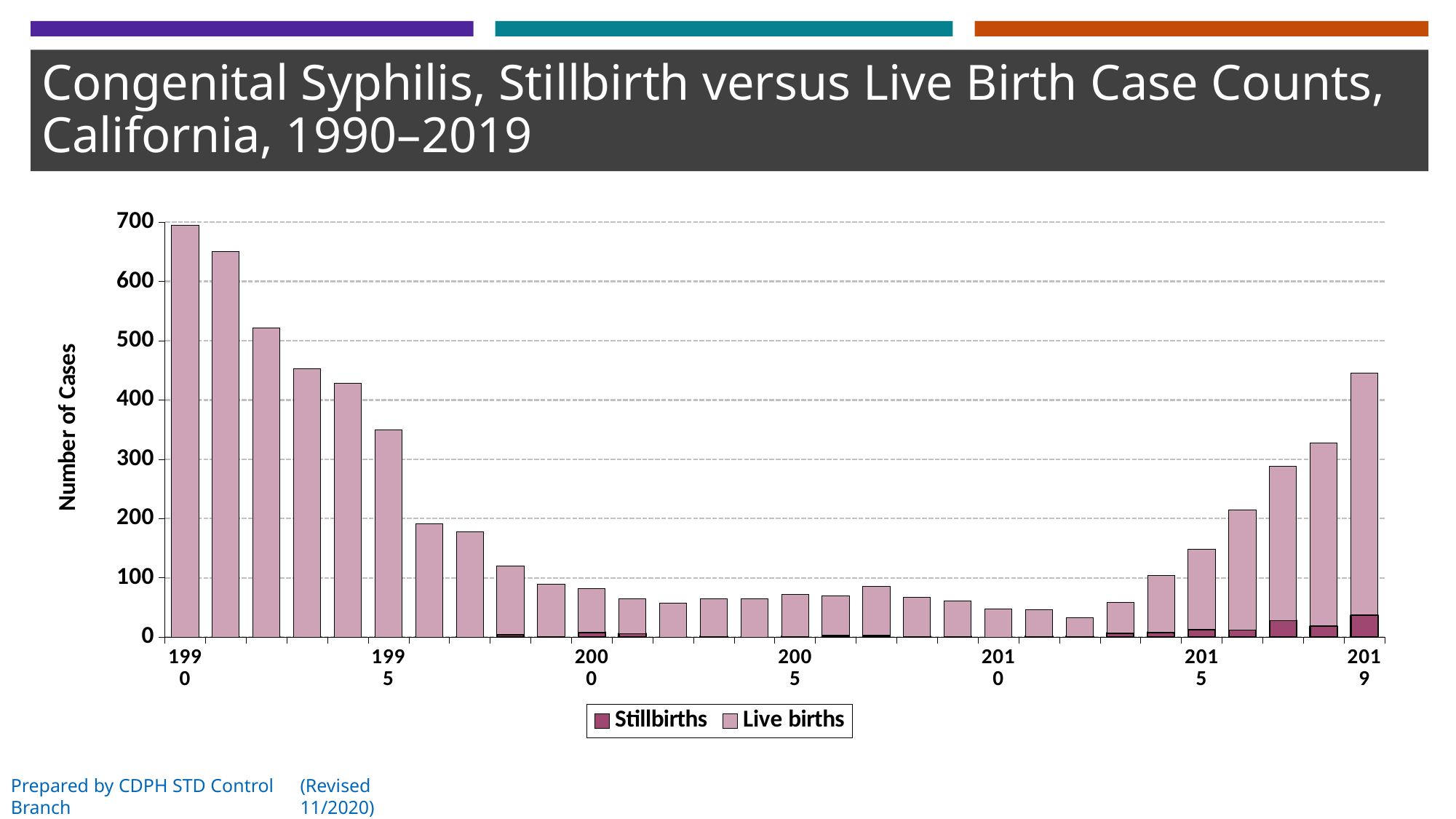
Which year has the highest total number of cases? 1990 Is the total number of cases in 2000 greater or less than 100? less Which year has a higher total number of cases, 1990 or 2019? 1990 Do the total case counts rise or fall from 1990 to 2000? Fall What kind of chart is shown on the slide? Stacked bar chart How many years (bars) are plotted on the chart? 30 What are the two series named in the legend? Stillbirths and Live births Is the total number of cases in 1990 greater or less than 600? greater Is the total number of cases in 2019 greater or less than 400? greater How many series does the legend list? 2 What is the label of the vertical axis? Number of Cases